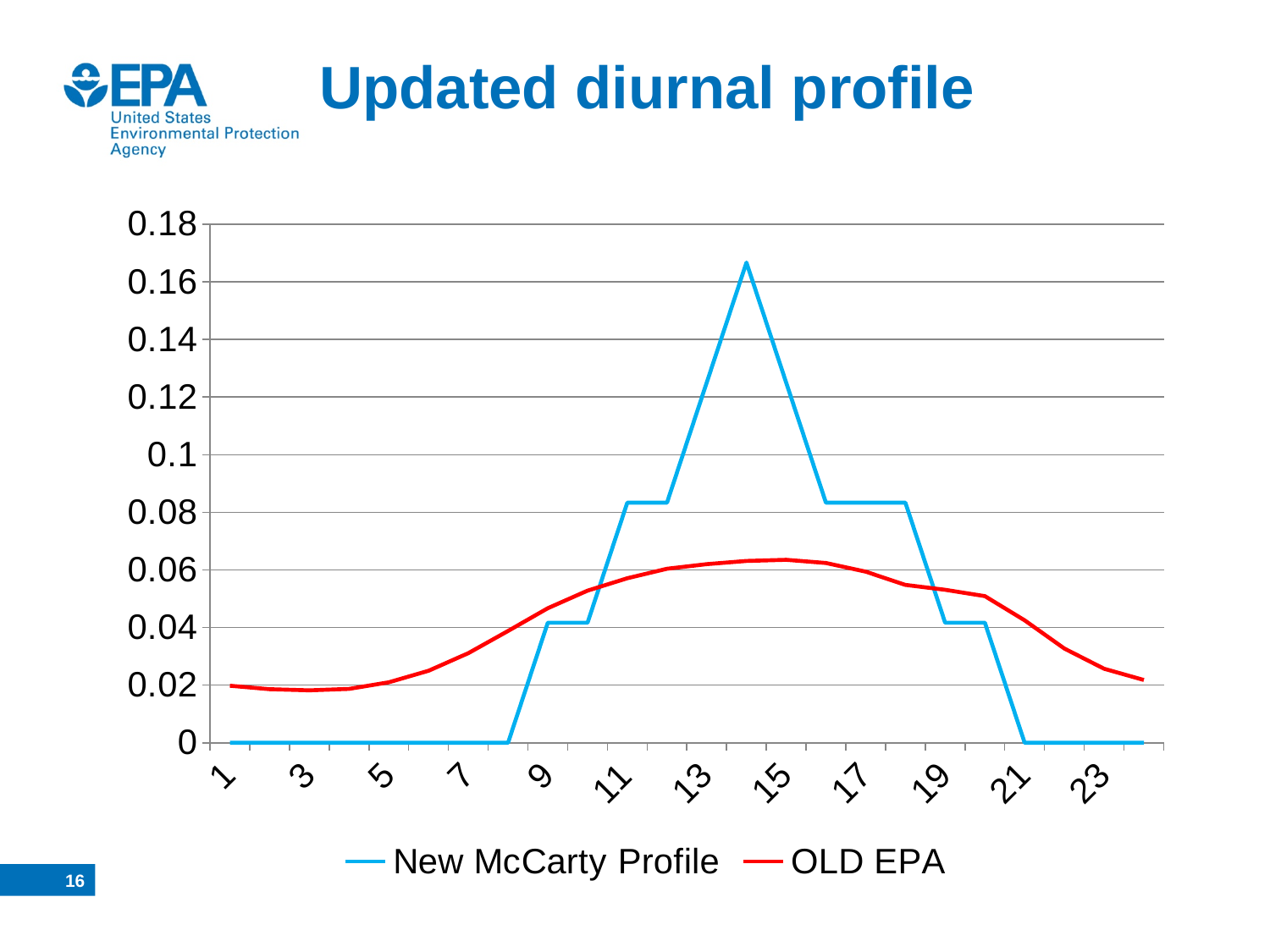
What is the value of the New McCarty Profile at hour 1? 0 What is the title of the chart on the slide? Updated diurnal profile Is the peak value of the New McCarty Profile greater or less than 0.16? greater At hour 5, which series has the higher value, New McCarty Profile or OLD EPA? OLD EPA What kind of chart is shown on the slide? line chart Is the OLD EPA value at hour 1 greater or less than 0.04? less What is the value of the New McCarty Profile at hour 23? 0 Is the peak value of the OLD EPA series greater or less than 0.08? less What colour is the OLD EPA line? red Which series reaches the highest value on the chart? New McCarty Profile How many series does the legend list? 2 Does the OLD EPA series rise or fall between hour 15 and hour 23? fall